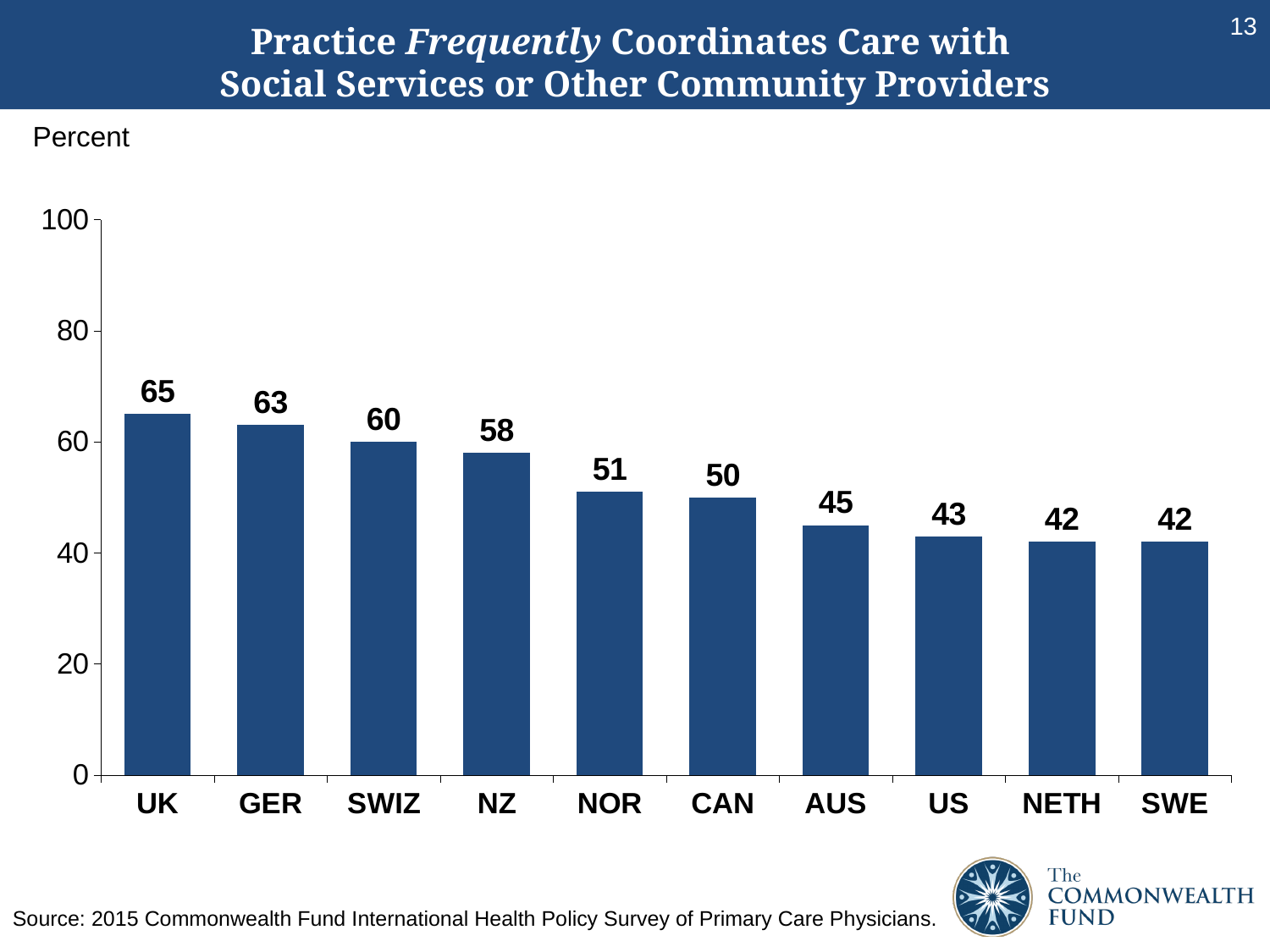
Which country has the highest value? UK Do the values rise or fall from left to right across the countries? fall What is the value for the UK? 65 Which is larger, the value for SWIZ or the value for US? SWIZ How many countries are shown on the chart? 10 What is the difference between the values for UK and SWE? 23 What is the value for NOR? 51 Is the value for NZ greater or less than 40? greater What is the difference between the values for GER and CAN? 13 What is the value for AUS? 45 What kind of chart is shown on the slide? bar chart